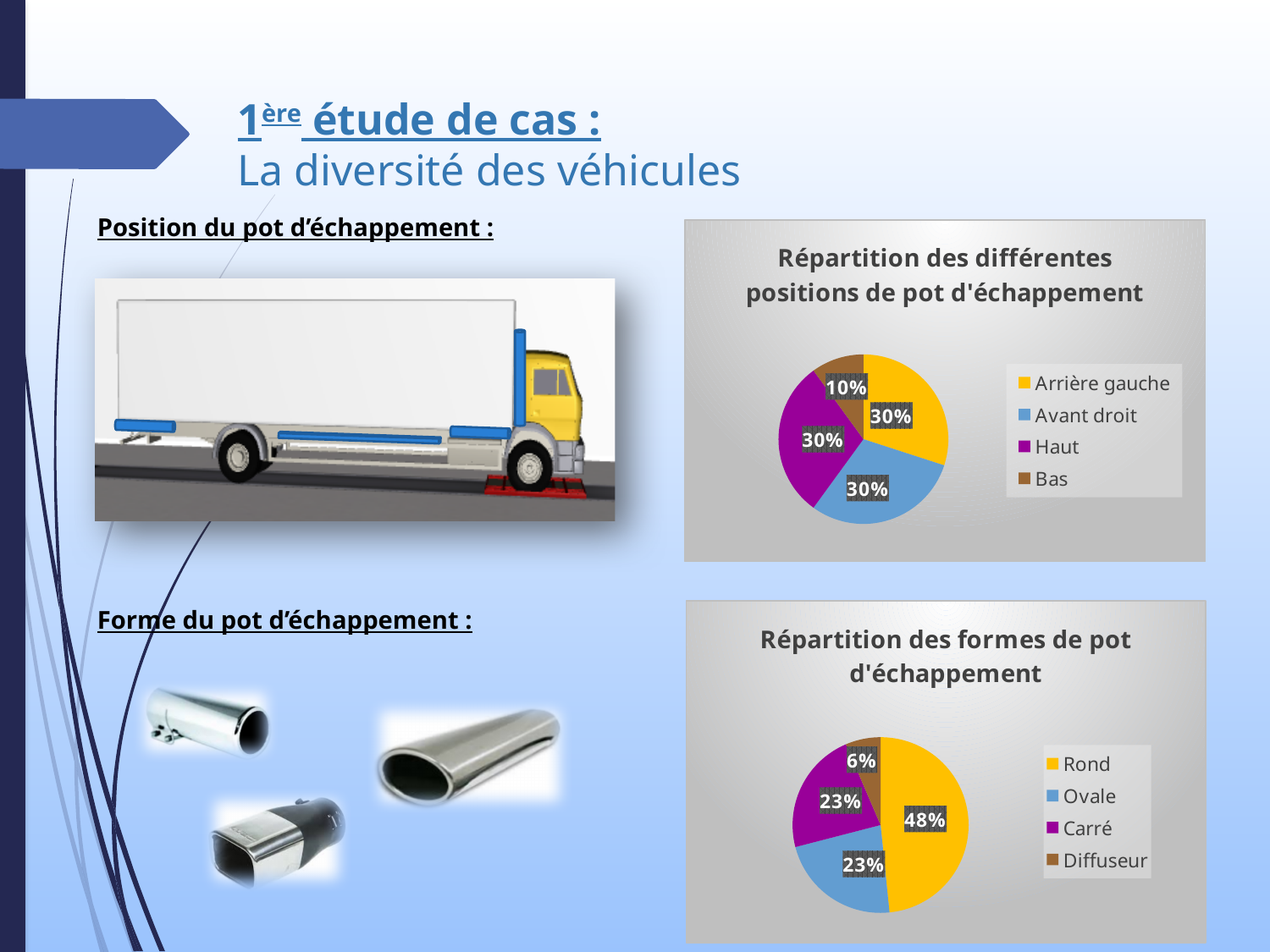
In the chart 'Répartition des formes de pot d'échappement', which category has the largest share? Rond In the chart 'Répartition des formes de pot d'échappement', what colour is the 'Ovale' slice? Light blue In the chart 'Répartition des différentes positions de pot d'échappement', what share does 'Haut' have? 30% What kind of chart is 'Répartition des différentes positions de pot d'échappement'? Pie chart In the chart 'Répartition des différentes positions de pot d'échappement', what share does 'Bas' have? 10% In the chart 'Répartition des formes de pot d'échappement', what share does 'Rond' have? 48% In the chart 'Répartition des formes de pot d'échappement', what share does 'Diffuseur' have? 6% In the chart 'Répartition des formes de pot d'échappement', what is the difference between the shares of 'Rond' and 'Ovale'? 25% In the chart 'Répartition des différentes positions de pot d'échappement', how many categories does the legend list? 4 In the chart 'Répartition des formes de pot d'échappement', which category has the smallest share? Diffuseur In the chart 'Répartition des formes de pot d'échappement', which is larger, the share of 'Rond' or the share of 'Carré'? Rond In the chart 'Répartition des différentes positions de pot d'échappement', which category has the smallest share? Bas